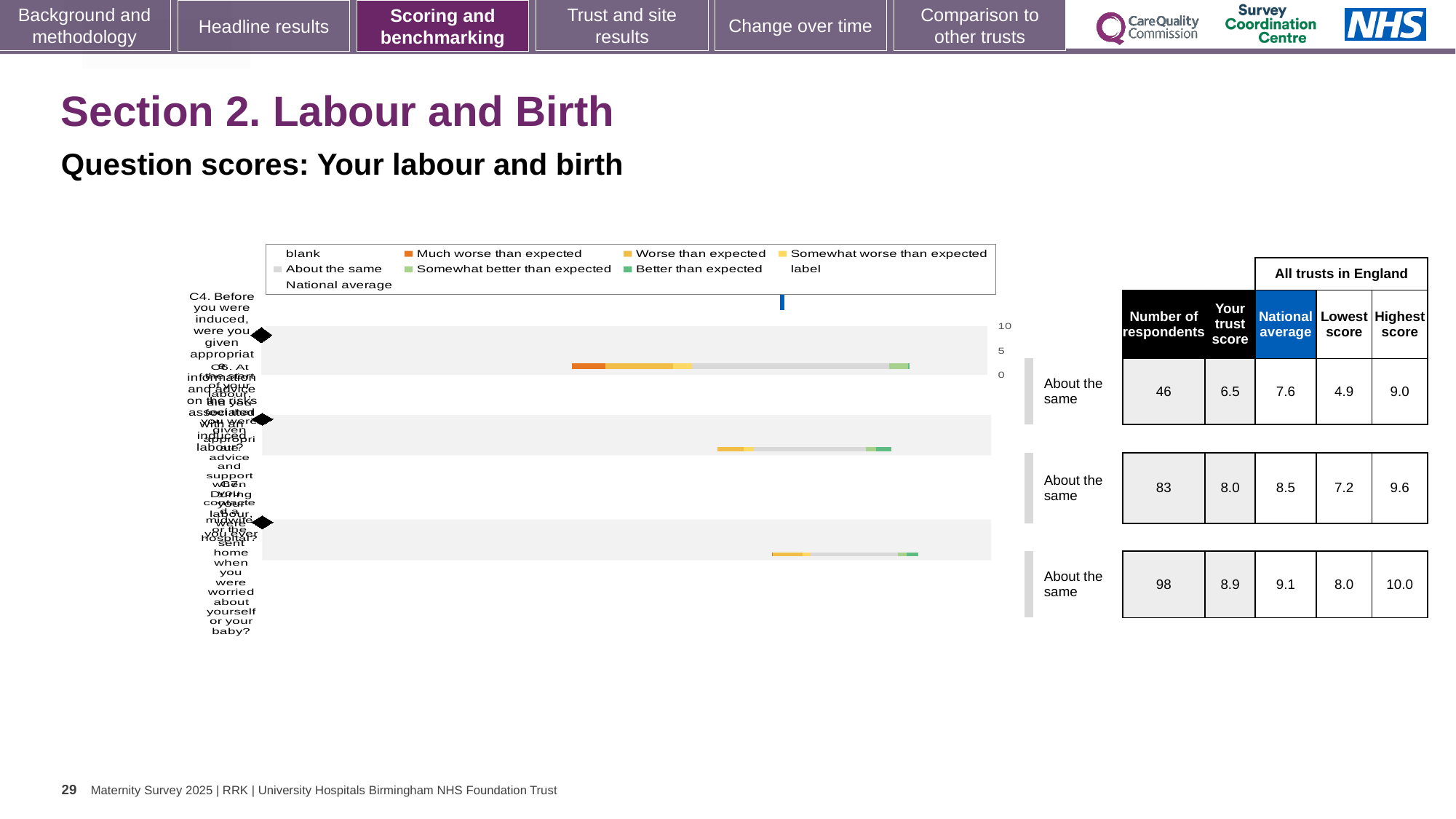
Which question row has the highest trust score? the third row (8.9) What is the national average for the second question row (83 respondents)? 8.5 How many question rows (bars) are plotted in the chart? 3 How many entries does the chart legend list? 9 Which legend entry is shown in dark green? Better than expected What is the benchmark rating shown for the first question row in the chart? About the same Is the trust score for the second question row larger or smaller than its national average? smaller What is the trust score for the first question row (46 respondents)? 6.5 What is the difference between the national average and the trust score for the first question row? 1.1 What kind of chart is shown on the slide? bar chart Which legend entry is shown in dark orange? Much worse than expected What is the highest score for the third question row (98 respondents)? 10.0